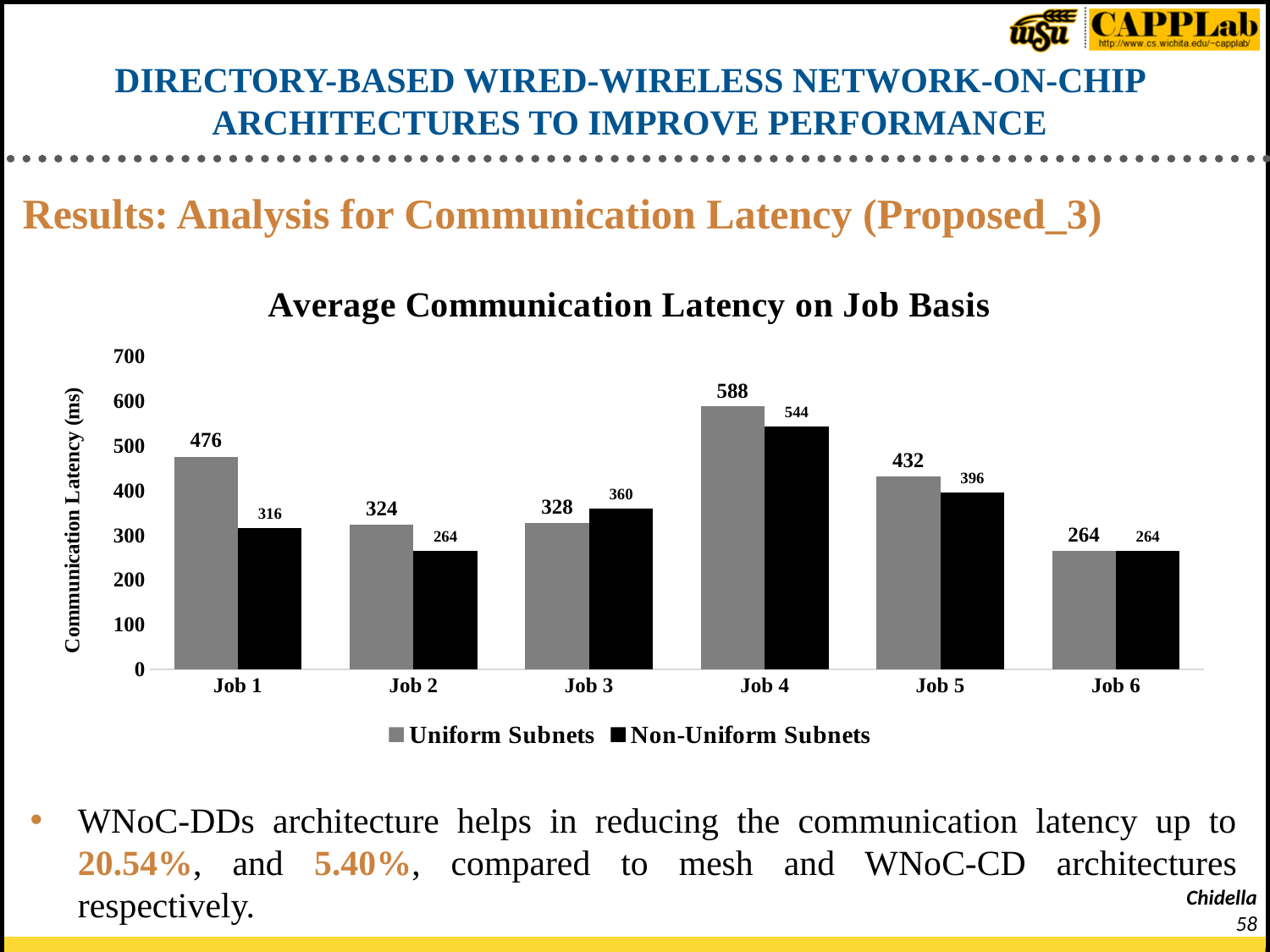
What is the Uniform Subnets communication latency for Job 1? 476 Which job has the highest Uniform Subnets latency? Job 4 What kind of chart is shown on the slide? Bar chart What is the Non-Uniform Subnets communication latency for Job 4? 544 How many jobs are shown on the x axis? 6 What is the title of the chart? Average Communication Latency on Job Basis What is the label of the y axis? Communication Latency (ms) For Job 3, which series has the larger latency, Uniform Subnets or Non-Uniform Subnets? Non-Uniform Subnets Is the Uniform Subnets value for Job 5 greater or less than 400? greater Which job has the lowest Non-Uniform Subnets latency? Job 2 and Job 6 How many series does the legend list? 2 What is the difference between the Uniform Subnets and Non-Uniform Subnets latency for Job 1? 160